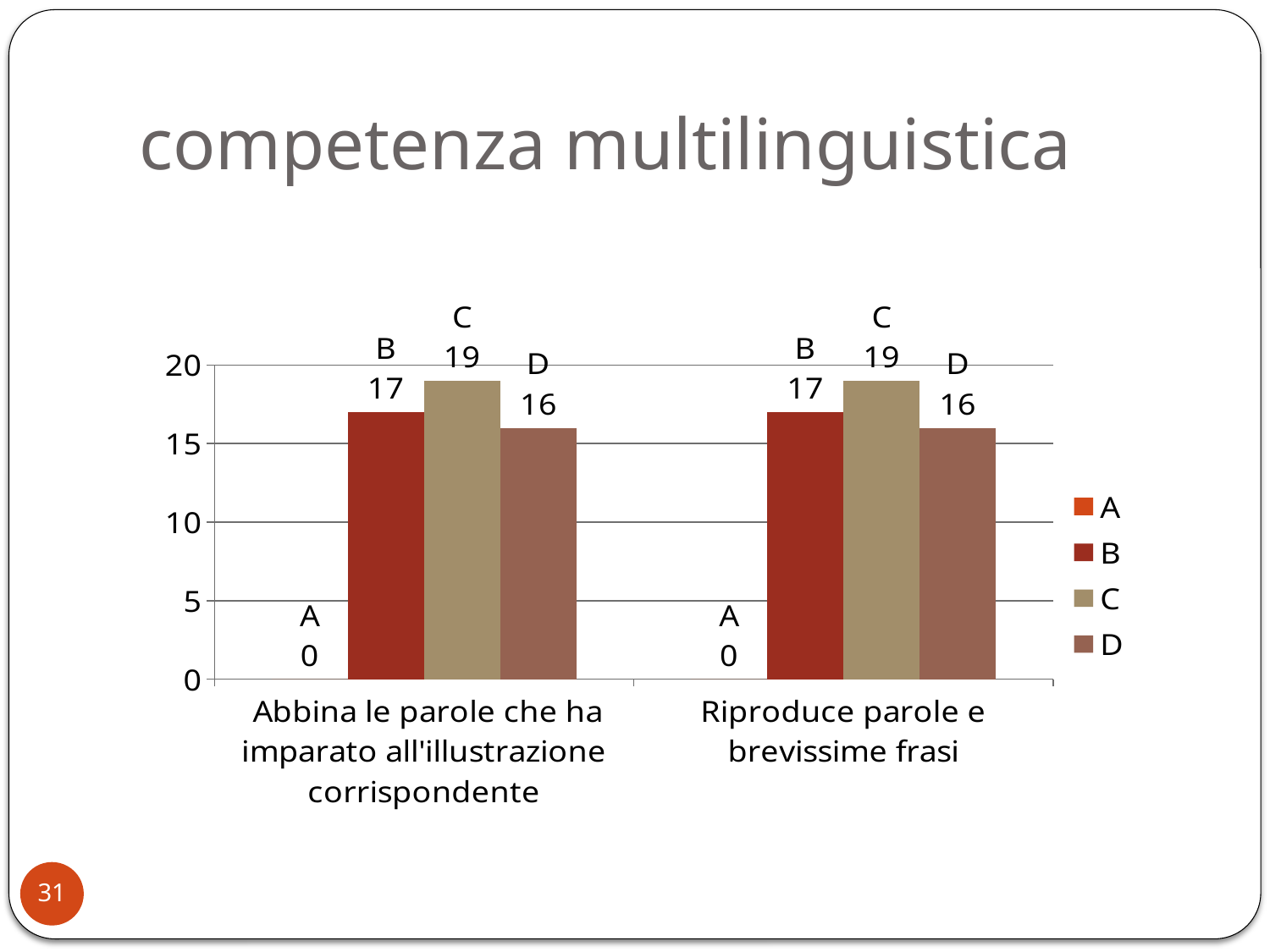
Which is larger in the category "Abbina le parole che ha imparato all'illustrazione corrispondente": the value for series B or series D? B What kind of chart is shown on the slide? Bar chart How many categories are shown on the x axis? 2 How many series does the legend list? 4 What is the value for series A in the category "Riproduce parole e brevissime frasi"? 0 What is the value for series B in the category "Riproduce parole e brevissime frasi"? 17 Which series has the highest value in the category "Riproduce parole e brevissime frasi"? C What is the value for series D in the category "Abbina le parole che ha imparato all'illustrazione corrispondente"? 16 Which series has the lowest value in the category "Abbina le parole che ha imparato all'illustrazione corrispondente"? A What is the value for series C in the category "Abbina le parole che ha imparato all'illustrazione corrispondente"? 19 What is the title of the slide? competenza multilinguistica What is the difference between the values for series C and series D in the category "Riproduce parole e brevissime frasi"? 3